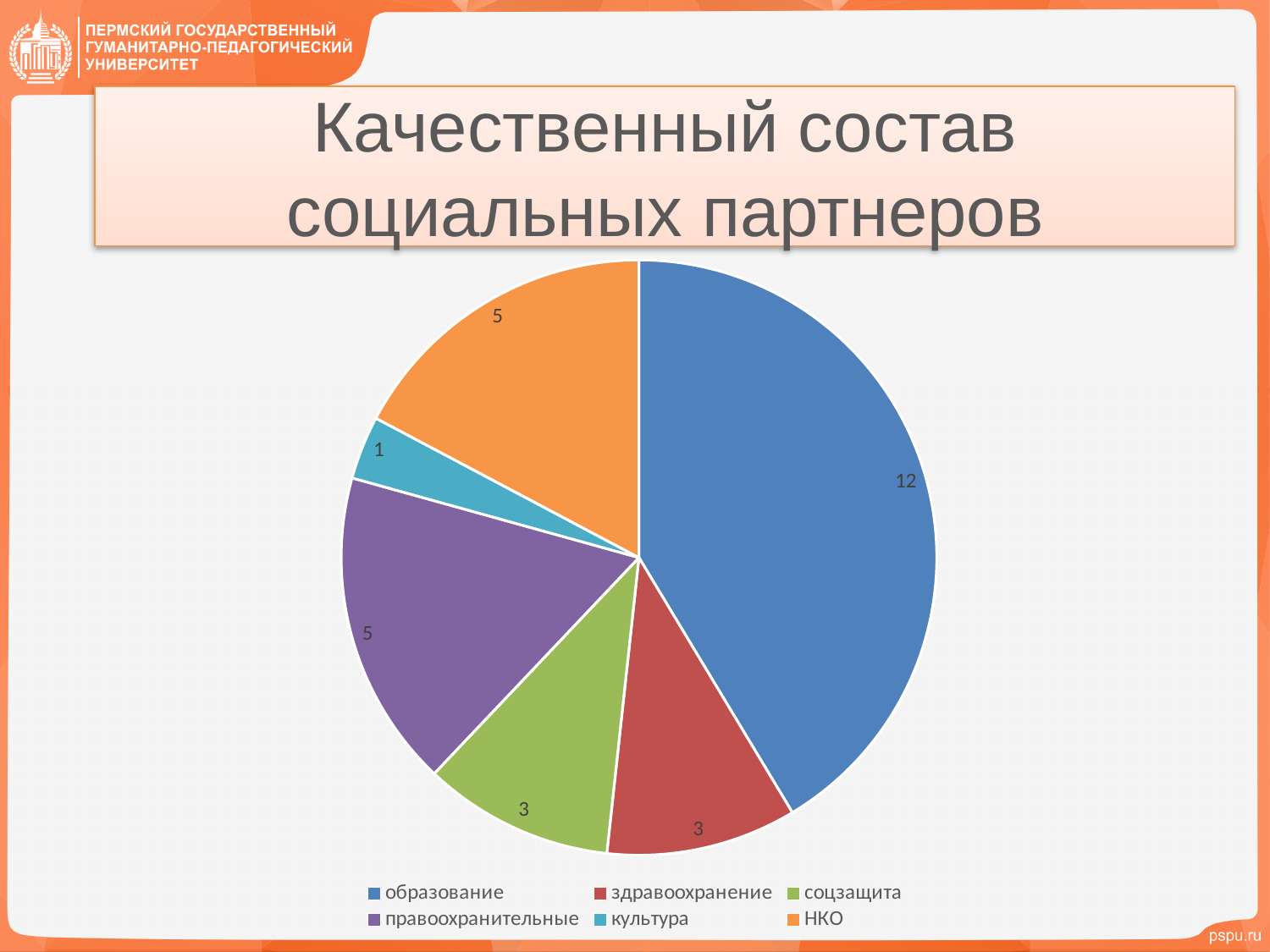
What is the value for культура? 1 What is the title of the slide containing the chart? Качественный состав социальных партнеров What is the value for образование? 12 What is the difference between the values for образование and НКО? 7 What is the value for правоохранительные? 5 Which category has the smallest slice of the pie? культура Which category has the largest slice of the pie? образование What is the total of all the slice values in the pie chart? 29 What type of chart is shown on the slide? pie chart How many categories does the pie chart have? 6 Which is larger, the value for правоохранительные or the value for здравоохранение? правоохранительные Which category is shown in orange in the pie chart? НКО